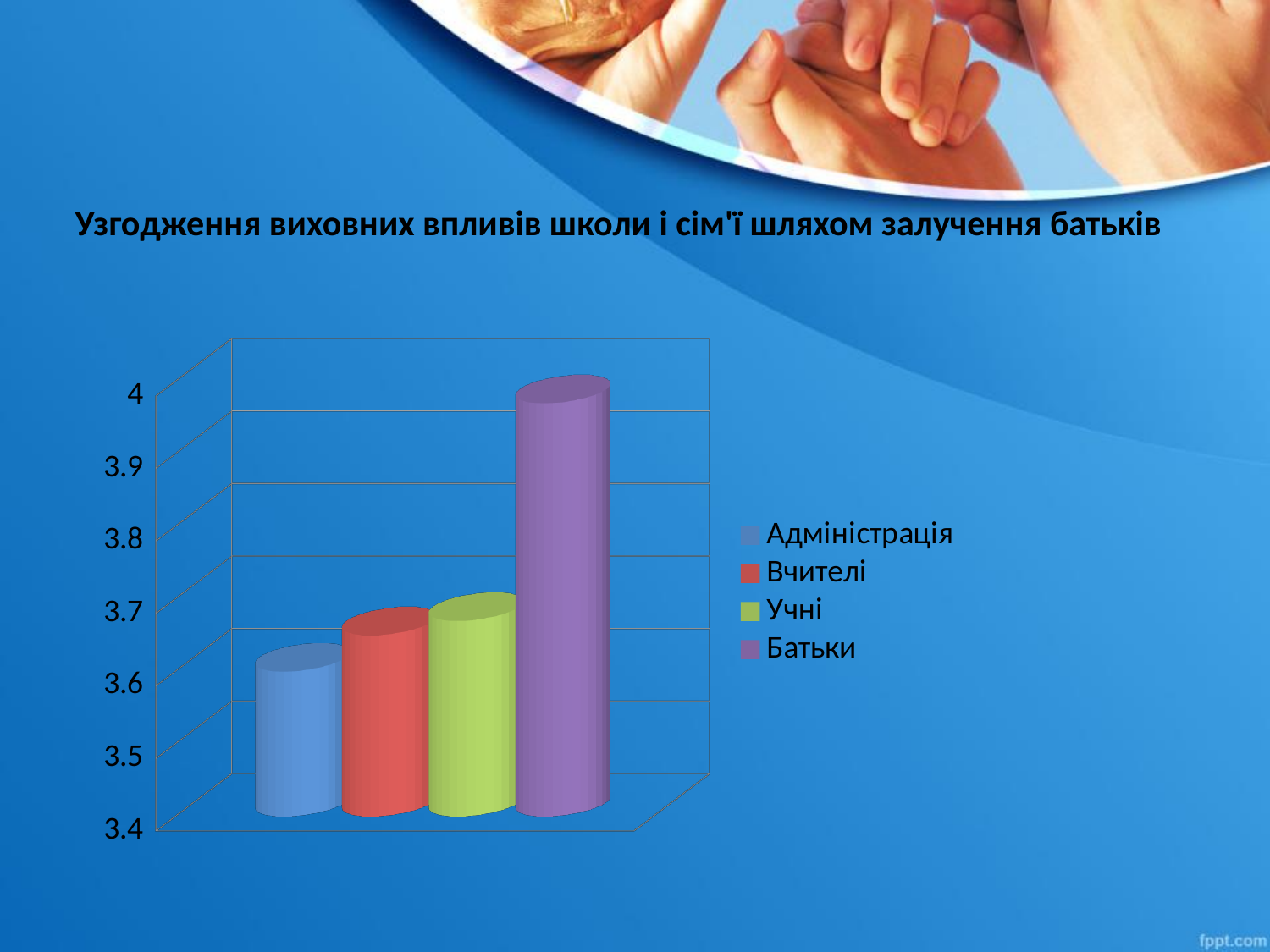
How many series does the legend list? 4 How many bars are plotted in the chart? 4 Which is larger, the value for Учні or the value for Адміністрація? Учні What kind of chart is shown on the slide? bar chart Is the value for Адміністрація greater or less than 3.7? less Is the value for Вчителі greater or less than 3.5? greater Which series has the highest value? Батьки Is the value for Учні greater or less than 3.8? less What is the title of the slide above the chart? Узгодження виховних впливів школи і сім'ї шляхом залучення батьків Which is larger, the value for Батьки or the value for Вчителі? Батьки Which series has the lowest value? Адміністрація